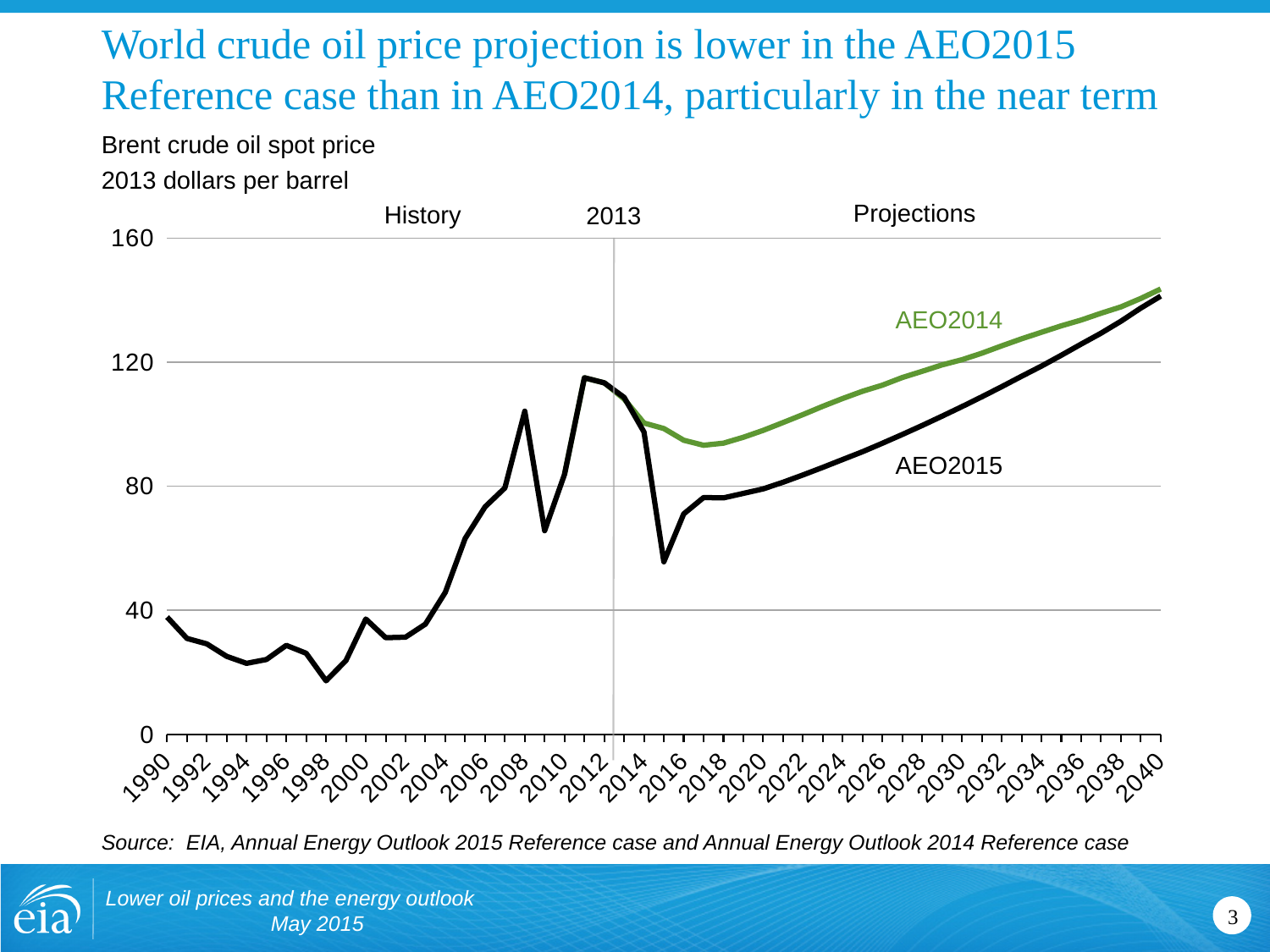
Is the AEO2015 value for 2016 greater or less than 80? less Is the AEO2014 value for 2018 greater or less than 80? greater Is the AEO2015 value for 2040 greater or less than 120? greater What units are the prices on the chart expressed in? 2013 dollars per barrel Which series is drawn in green? AEO2014 In 2020, which projection is higher, AEO2014 or AEO2015? AEO2014 How many projection series are labeled on the chart? 2 Does the AEO2015 projection rise or fall between 2020 and 2040? rise What kind of chart is shown on the slide? line chart